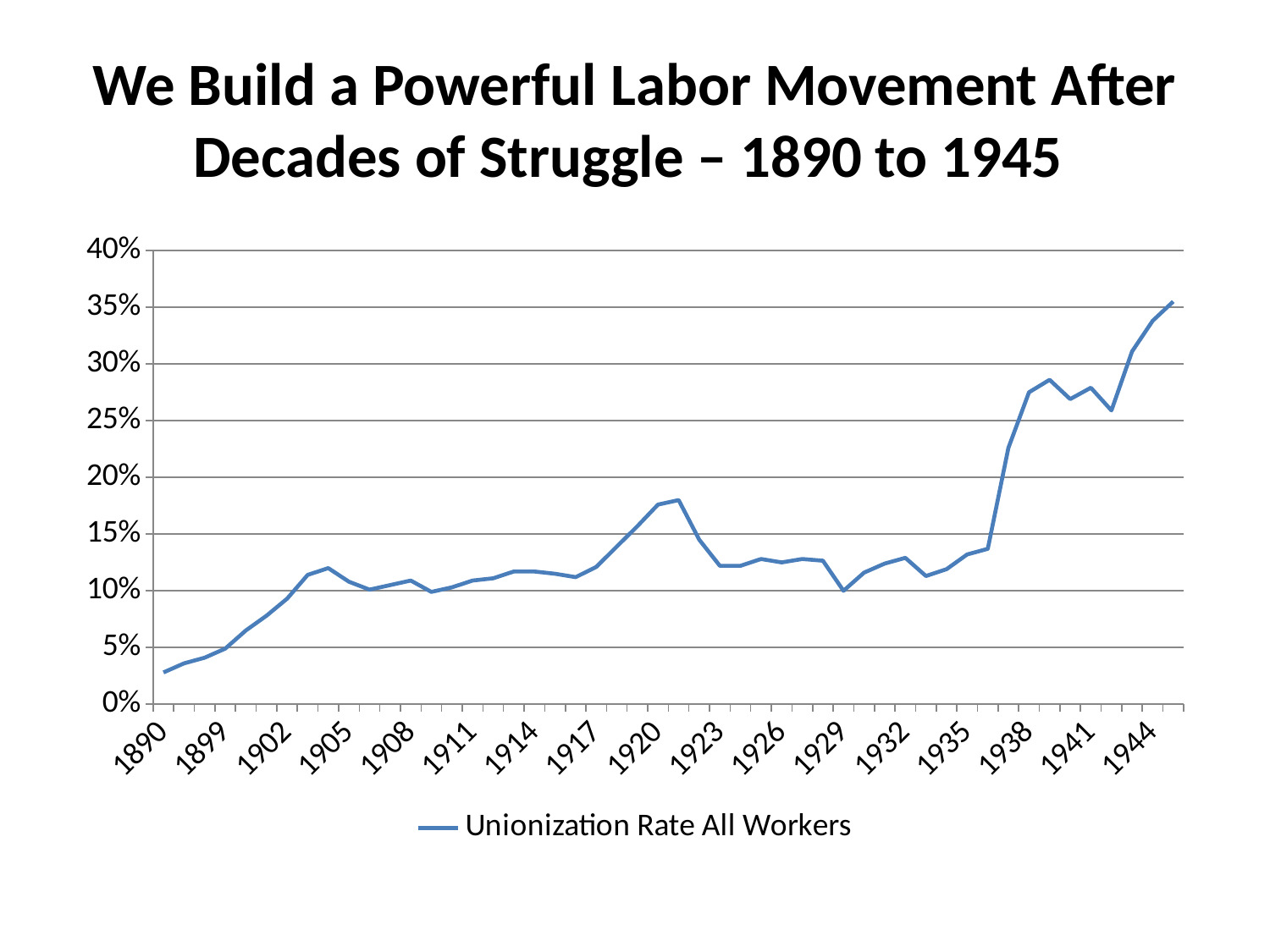
Overall, does the unionization rate rise or fall from 1890 to the end of the series? rise Is the unionization rate for 1920 greater or less than 15%? greater What is the name of the series shown in the legend? Unionization Rate All Workers How many series does the legend list? 1 Is the unionization rate for 1923 greater or less than 15%? less What kind of chart is shown on the slide? line chart Is the unionization rate for 1935 greater or less than 20%? less Which year has the higher unionization rate, 1890 or 1944? 1944 What is the title of the slide containing the chart? We Build a Powerful Labor Movement After Decades of Struggle – 1890 to 1945